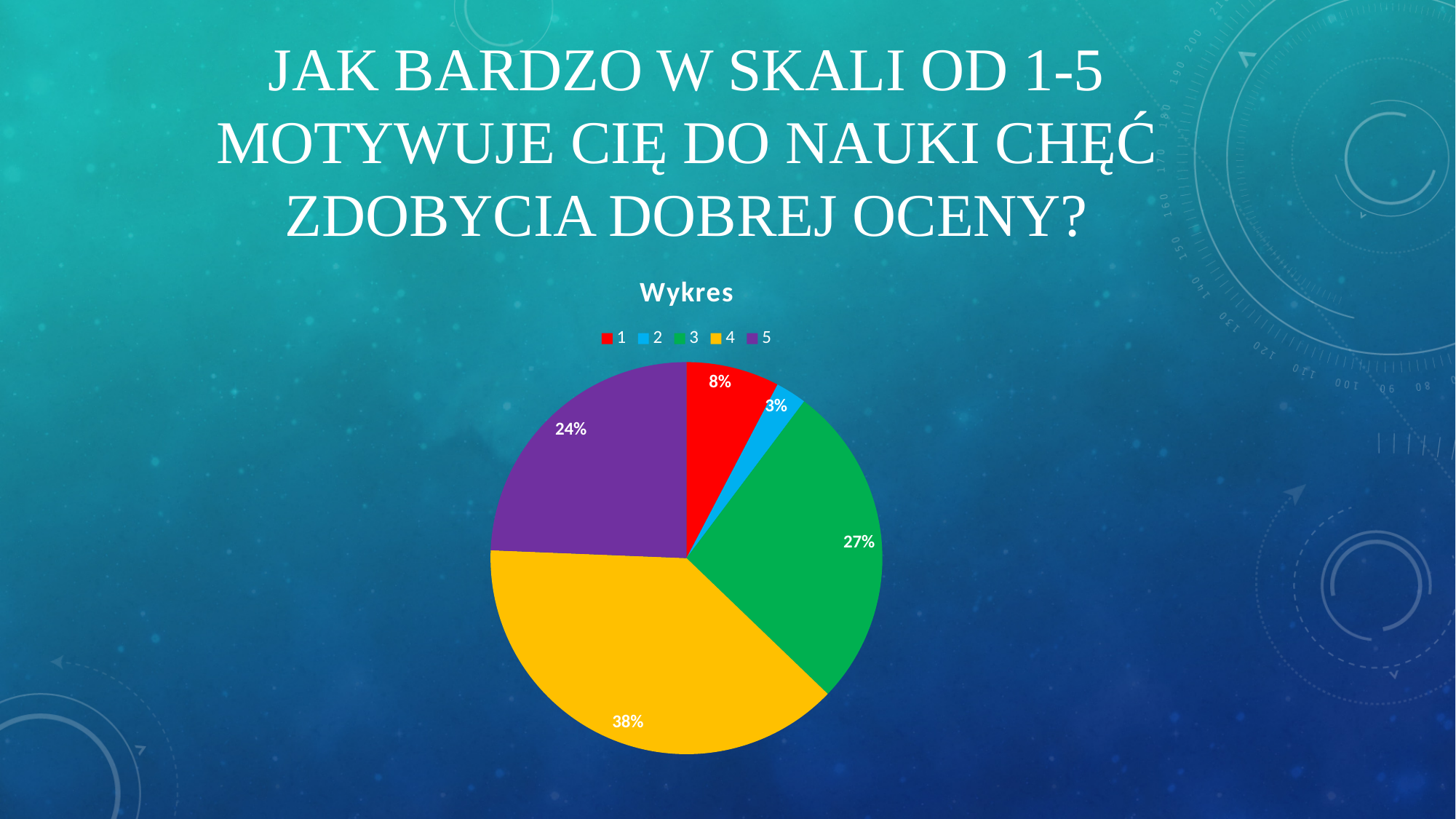
What is the difference in percentage points between category 4 and category 3? 11 Which category has the smallest slice? 2 What percentage is shown for category 1? 8% How many categories does the legend list? 5 What percentage is shown for category 4? 38% What colour is the slice for category 3? green Which is larger, the slice for category 3 or the slice for category 5? 3 What is the chart's title? Wykres Which category has the largest slice? 4 What type of chart is shown on the slide? pie chart What percentage is shown for category 5? 24% What percentage is shown for category 2? 3%